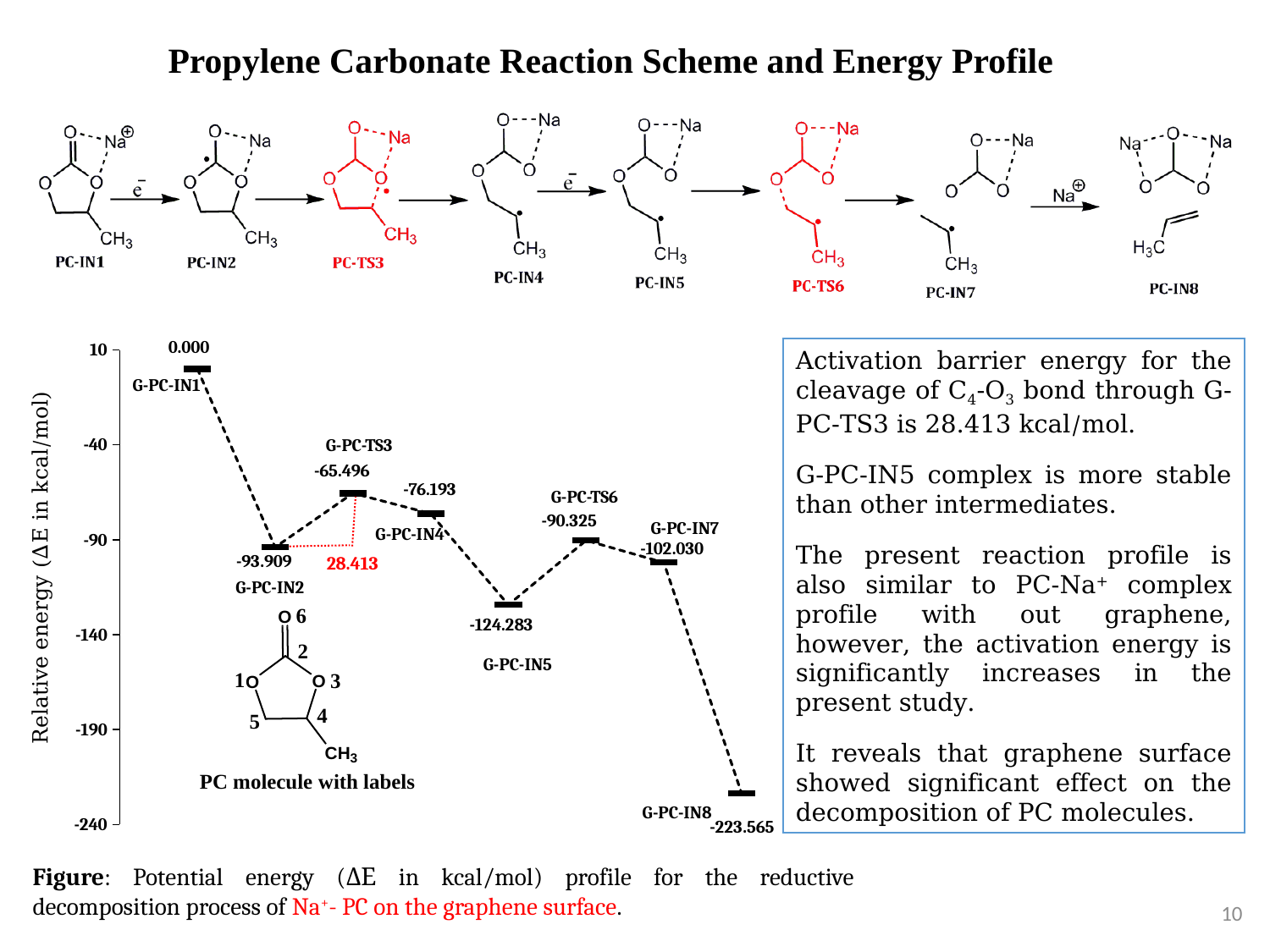
Which species has the lowest relative energy in the energy profile? G-PC-IN8 What is the relative energy of G-PC-IN2 in the energy profile? -93.909 Is the relative energy of G-PC-IN5 greater or less than -90 kcal/mol? less What is the difference in relative energy between G-PC-TS3 and G-PC-IN2 in the energy profile? 28.413 What is the relative energy of G-PC-TS6 in the energy profile? -90.325 What is the y-axis label of the energy profile chart? Relative energy (ΔE in kcal/mol) Which has a higher relative energy in the energy profile, G-PC-IN4 or G-PC-IN7? G-PC-IN4 What is the relative energy of G-PC-IN5 in the energy profile? -124.283 Which species has the highest relative energy in the energy profile? G-PC-IN1 What is the relative energy of G-PC-TS3 in the energy profile? -65.496 What is the relative energy of G-PC-IN8 in the energy profile? -223.565 How many species (points) are plotted in the energy profile? 8